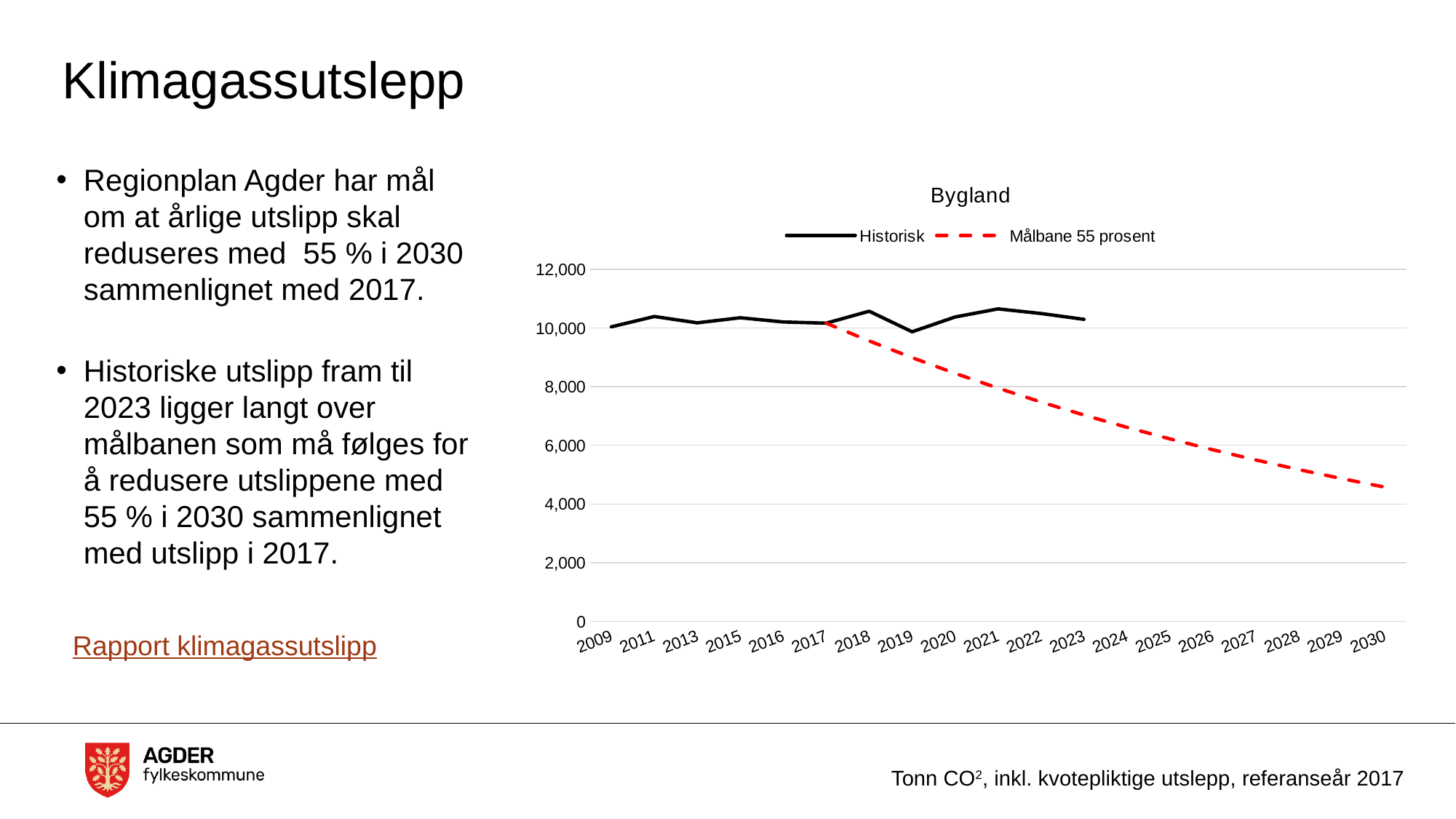
In 2023, which series has the higher value, Historisk or Målbane 55 prosent? Historisk What are the two series named in the chart legend? Historisk and Målbane 55 prosent How many years are labelled on the x axis of the chart? 19 Is the value of the Historisk series in 2021 greater or less than 10,000? greater What kind of chart is shown on the slide? Line chart What is the title of the chart? Bygland Is the value of the Målbane 55 prosent series in 2025 greater or less than 8,000? less Is the value of the Målbane 55 prosent series in 2030 greater or less than 4,000? greater Does the Målbane 55 prosent series rise or fall from 2017 to 2030? Fall How many series does the chart legend list? 2